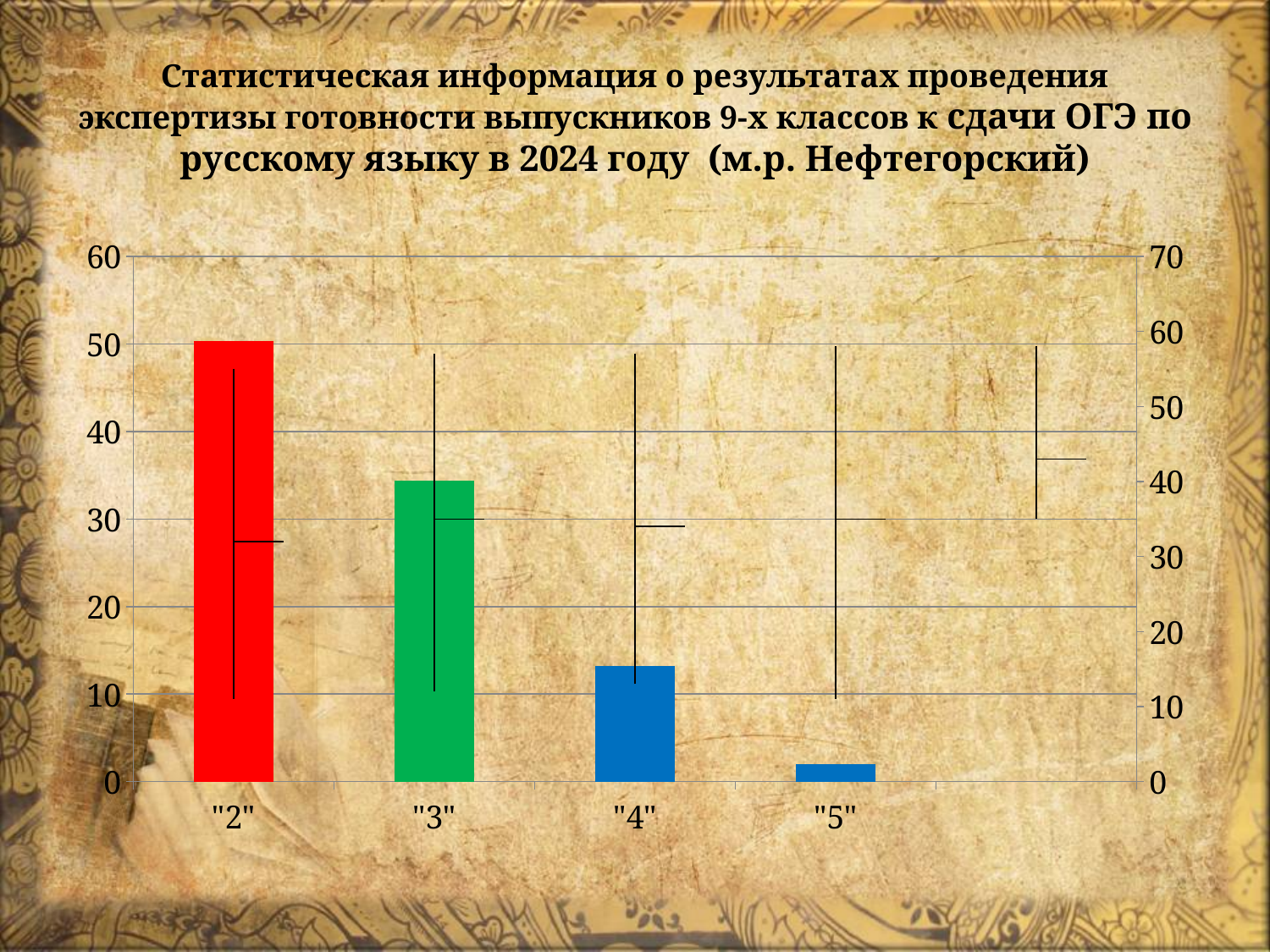
On the left axis, is the value for "2" greater or less than 40? greater On the left axis, is the value for "5" greater or less than 10? less Which category has the shortest bar? "5" Which bar is taller, "3" or "4"? "3" Which bar is taller, "2" or "3"? "2" On the left axis, is the value for "3" greater or less than 30? greater How many bars are plotted in the chart? 4 What kind of chart is shown on the slide? bar chart Which category has the tallest bar? "2" Do the bar heights rise or fall from "2" to "5" along the x axis? fall